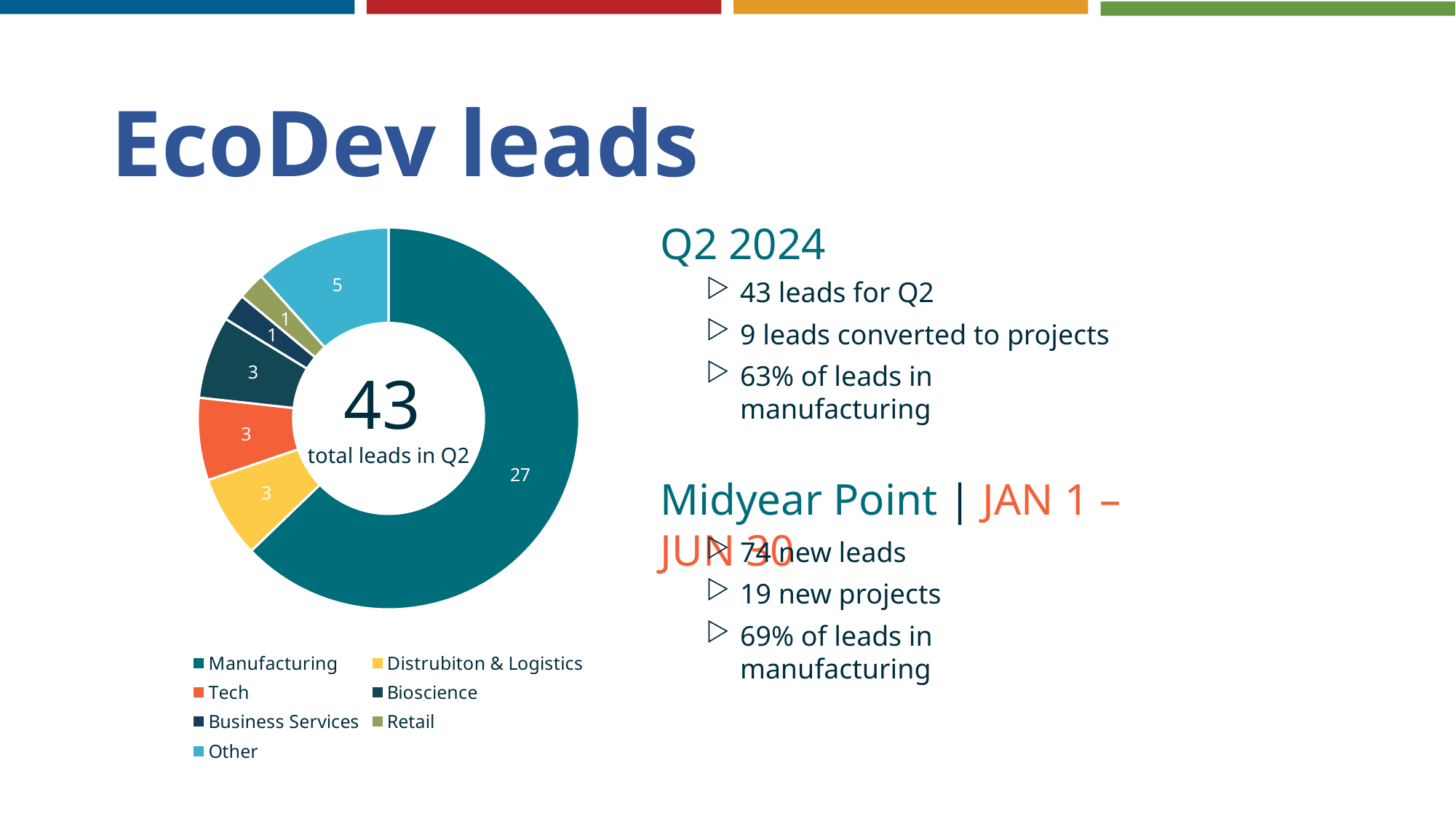
Which category has the largest number of leads in the chart? Manufacturing How many leads does the chart show for Manufacturing? 27 Which has more leads, Other or Bioscience? Other How many leads does the chart show for Retail? 1 How many leads does the chart show for Other? 5 How many categories does the chart show? 7 How many leads does the chart show for Tech? 3 What type of chart is shown on the slide? Doughnut chart Which two categories have the smallest number of leads in the chart? Business Services and Retail What is the difference between the Manufacturing leads and the Other leads? 22 What share of total leads does Manufacturing represent? 63% What is the total number of leads shown in the centre of the chart? 43